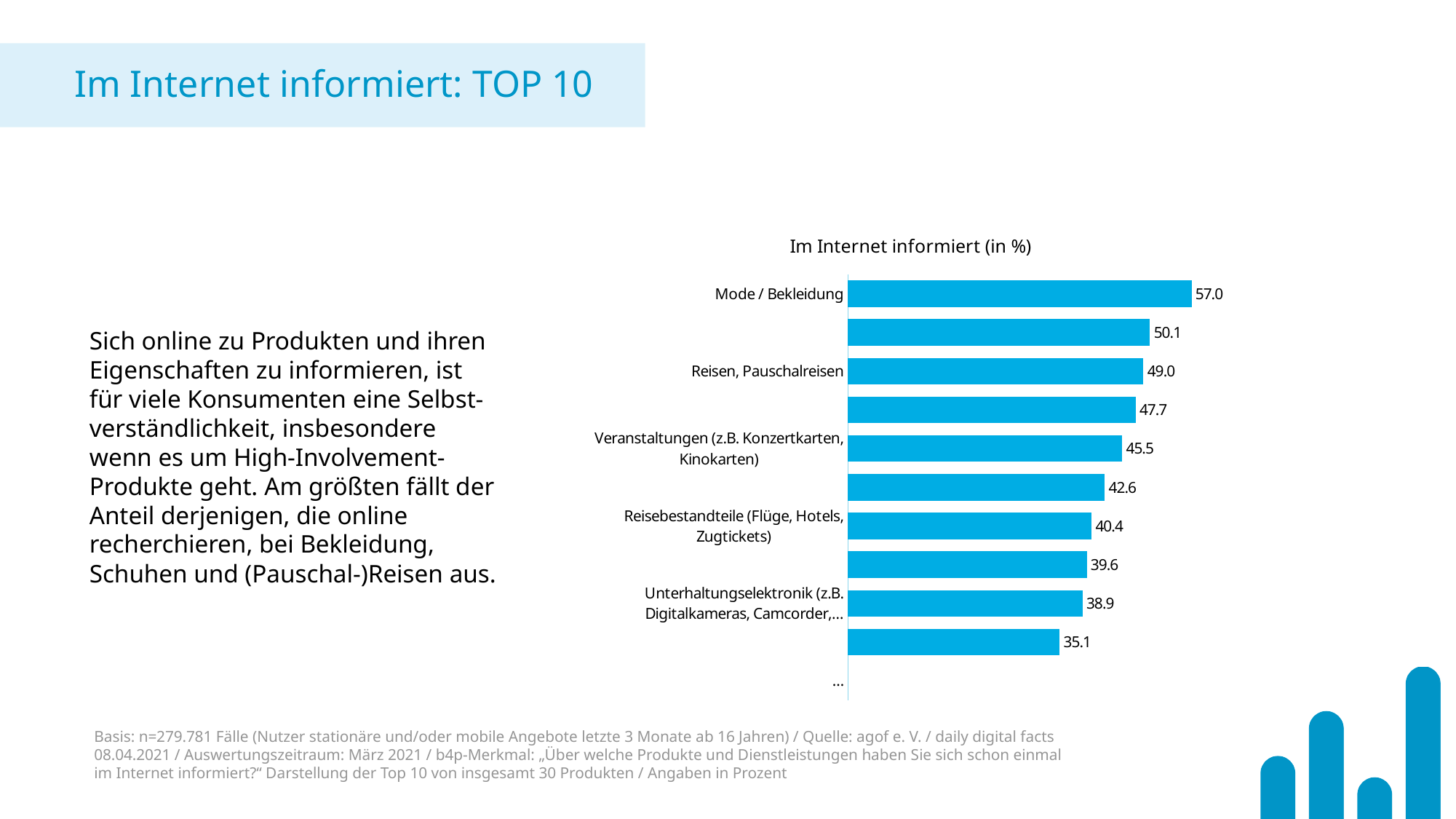
How many bars are plotted in the chart? 10 What is the lowest value shown in the chart? 35.1 Which has a larger value: Veranstaltungen (z.B. Konzertkarten, Kinokarten) or Reisebestandteile (Flüge, Hotels, Zugtickets)? Veranstaltungen (z.B. Konzertkarten, Kinokarten) What is the value for Unterhaltungselektronik (z.B. Digitalkameras, Camcorder,...)? 38.9 What is the value for Reisen, Pauschalreisen? 49.0 What type of chart is shown on the slide? bar chart What is the value for Mode / Bekleidung? 57.0 What is the difference between the values for Mode / Bekleidung and Reisen, Pauschalreisen? 8.0 What is the value for Reisebestandteile (Flüge, Hotels, Zugtickets)? 40.4 What is the value for Veranstaltungen (z.B. Konzertkarten, Kinokarten)? 45.5 Which category has the highest value in the chart? Mode / Bekleidung What is the title of the chart? Im Internet informiert (in %)